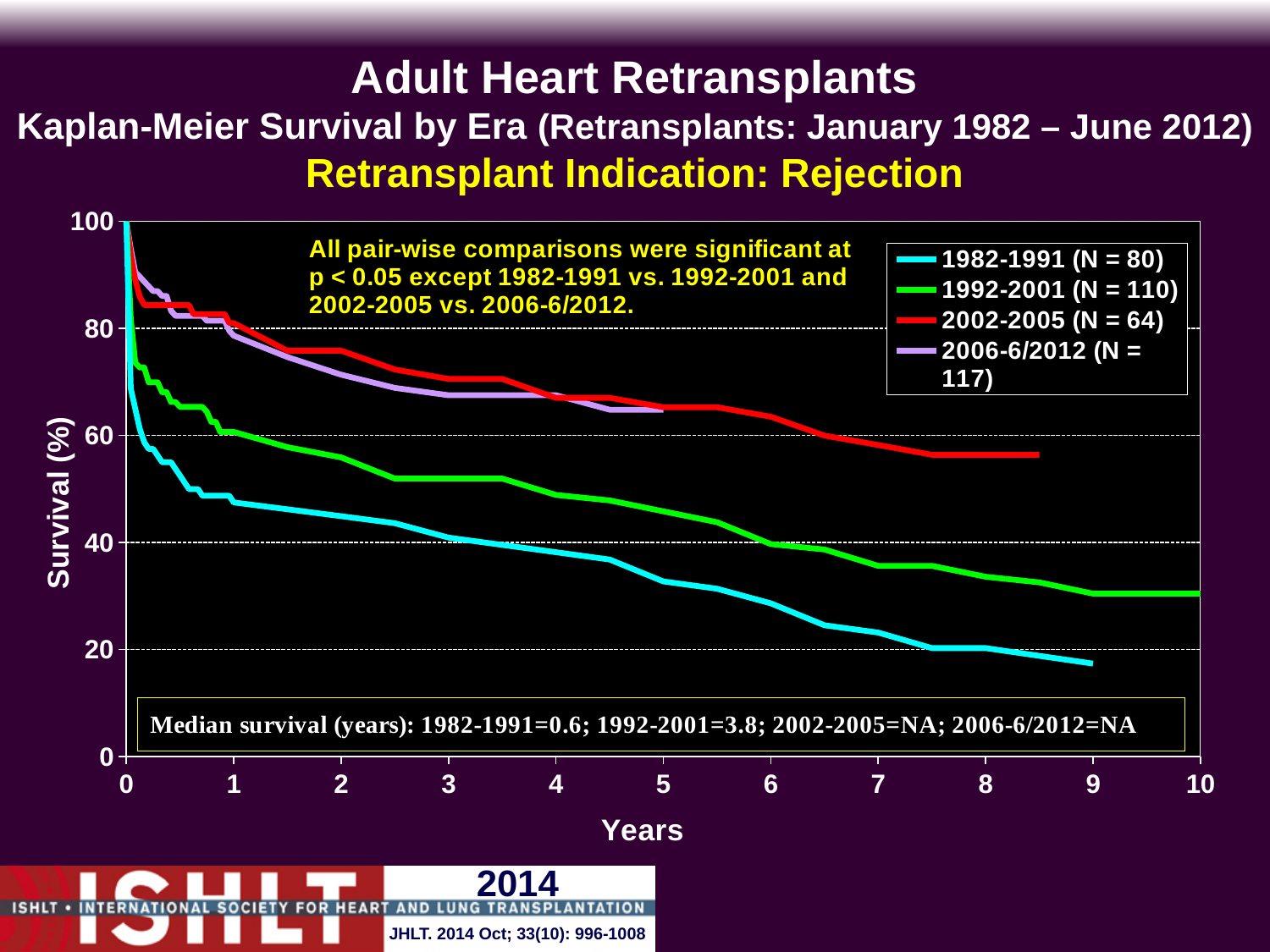
According to the legend, what is N for the 2006-6/2012 era? 117 According to the legend, what is N for the 1982-1991 era? 80 What is the median survival in years for the 1982-1991 era? 0.6 What is the median survival in years for the 1992-2001 era? 3.8 What kind of chart is shown on the slide? line chart Is the survival for the 1992-2001 era at 10 years greater or less than 40? less Is the survival for the 1982-1991 era at 5 years greater or less than 40? less At 5 years, which era has higher survival, 1982-1991 or 1992-2001? 1992-2001 How many series does the legend list? 4 What is the median survival for the 2002-2005 era? NA Which era has the lowest survival curve across the chart? 1982-1991 Is the survival for the 2002-2005 era at 5 years greater or less than 60? greater